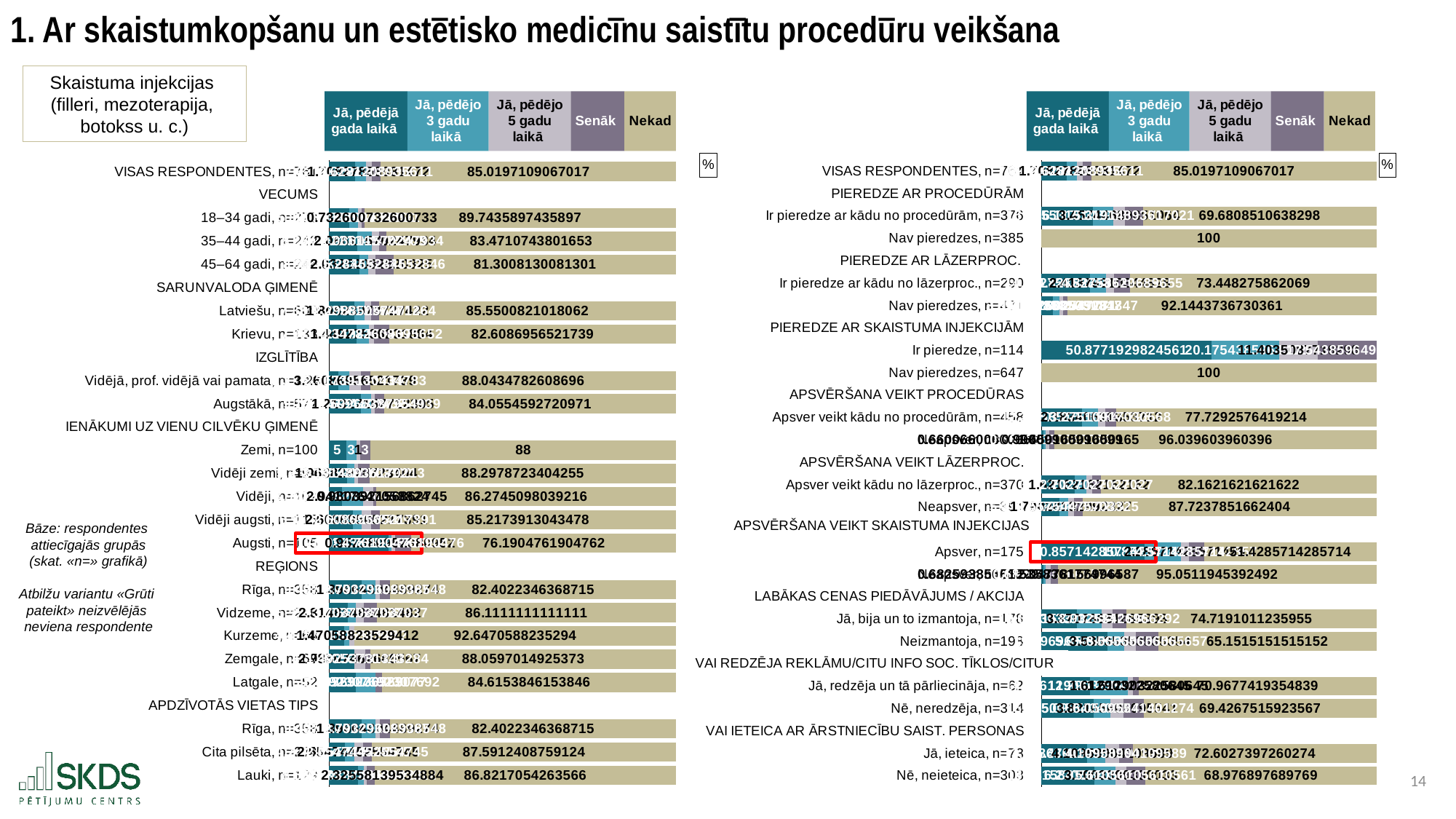
How many series does the legend of the left chart list? 5 What kind of chart is used on the left side of the slide? Stacked bar chart In the left chart, what is the 'Nekad' value for 'Augsti'? 76.1904761904762 In the left chart, which income group under 'IENĀKUMI UZ VIENU CILVĒKU ĢIMENĒ' has the lowest 'Nekad' value? Augsti In the left chart, what is the 'Nekad' value for 'VISAS RESPONDENTES'? 85.0197109067017 In the right chart, what is the 'Nekad' value for 'Nav pieredzes' under 'PIEREDZE AR PROCEDŪRĀM'? 100 In the left chart, which region under 'REĢIONS' has the highest 'Nekad' value? Kurzeme In the left chart, what is the 'Nekad' value for 'Kurzeme'? 92.6470588235294 In the left chart, which has a larger 'Nekad' value: '18–34 gadi' or '45–64 gadi'? 18–34 gadi In the right chart, which has a larger 'Nekad' value: 'Jā, ieteica' or 'Nē, neieteica'? Jā, ieteica In the left chart, what is the difference between the 'Nekad' values for 'Kurzeme' and 'Zemi'? 4.6470588235294 In the right chart, what is the 'Jā, pēdējā gada laikā' value for 'Ir pieredze, n=114' under 'PIEREDZE AR SKAISTUMA INJEKCIJĀM'? 50.8771929824561